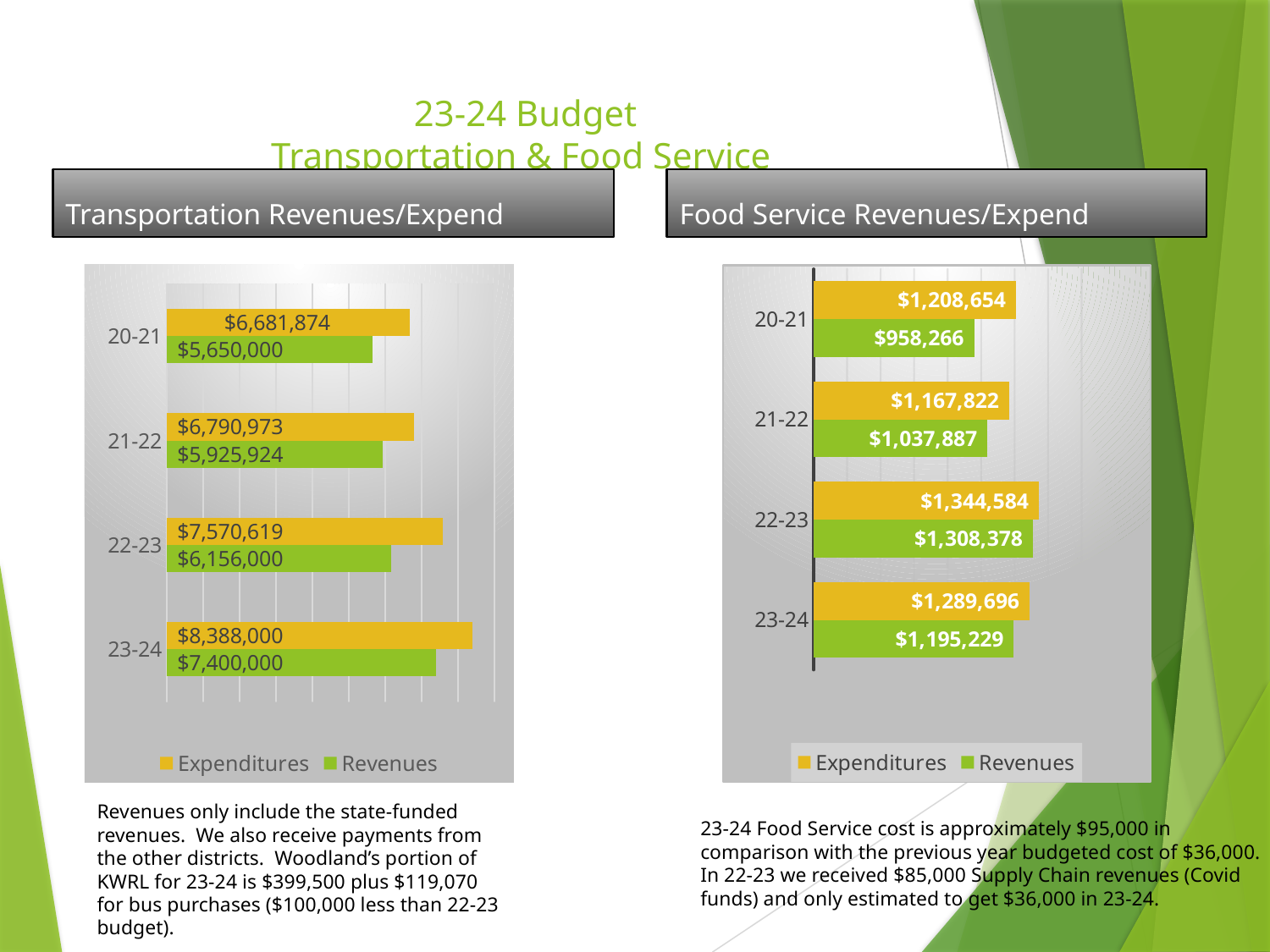
How many series does the legend of the Food Service Revenues/Expend chart list? 2 In the Food Service Revenues/Expend chart, what are the Revenues for 20-21? $958,266 In the Transportation Revenues/Expend chart, what are the Revenues for 21-22? $5,925,924 In the Transportation Revenues/Expend chart, what are the Expenditures for 23-24? $8,388,000 In the Transportation Revenues/Expend chart, which year has the highest Expenditures? 23-24 In the Transportation Revenues/Expend chart, what is the difference between Expenditures and Revenues for 23-24? $988,000 How many years are shown in the Transportation Revenues/Expend chart? 4 In the Food Service Revenues/Expend chart, which year has the lowest Revenues? 20-21 What kind of chart is the Transportation Revenues/Expend chart? Bar chart In the Food Service Revenues/Expend chart, which is larger for 21-22, Expenditures or Revenues? Expenditures In the Food Service Revenues/Expend chart, what is the difference between Expenditures and Revenues for 22-23? $36,206 In the Food Service Revenues/Expend chart, what are the Expenditures for 22-23? $1,344,584